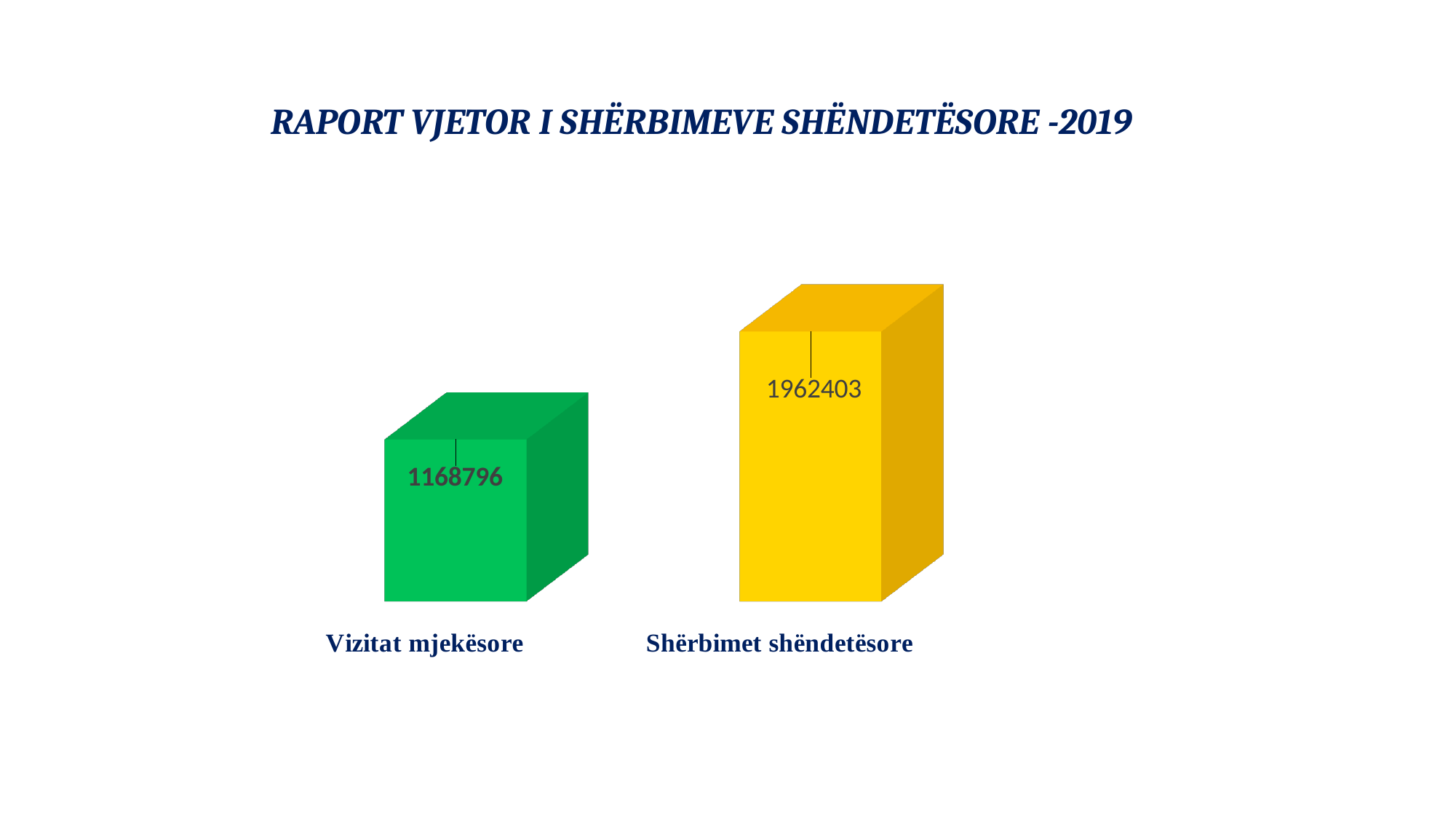
What is the total of the two values shown in the chart? 3131199 What kind of chart is shown on the slide? Bar chart What is the title of the slide? RAPORT VJETOR I SHËRBIMEVE SHËNDETËSORE -2019 What is the difference between the values for Shërbimet shëndetësore and Vizitat mjekësore? 793607 Which category has the highest value? Shërbimet shëndetësore How many categories are shown in the chart? 2 Which category has the lowest value? Vizitat mjekësore Which is larger, the value for Vizitat mjekësore or the value for Shërbimet shëndetësore? Shërbimet shëndetësore What colour is the bar for Shërbimet shëndetësore? Yellow What is the value for Shërbimet shëndetësore? 1962403 What is the value for Vizitat mjekësore? 1168796